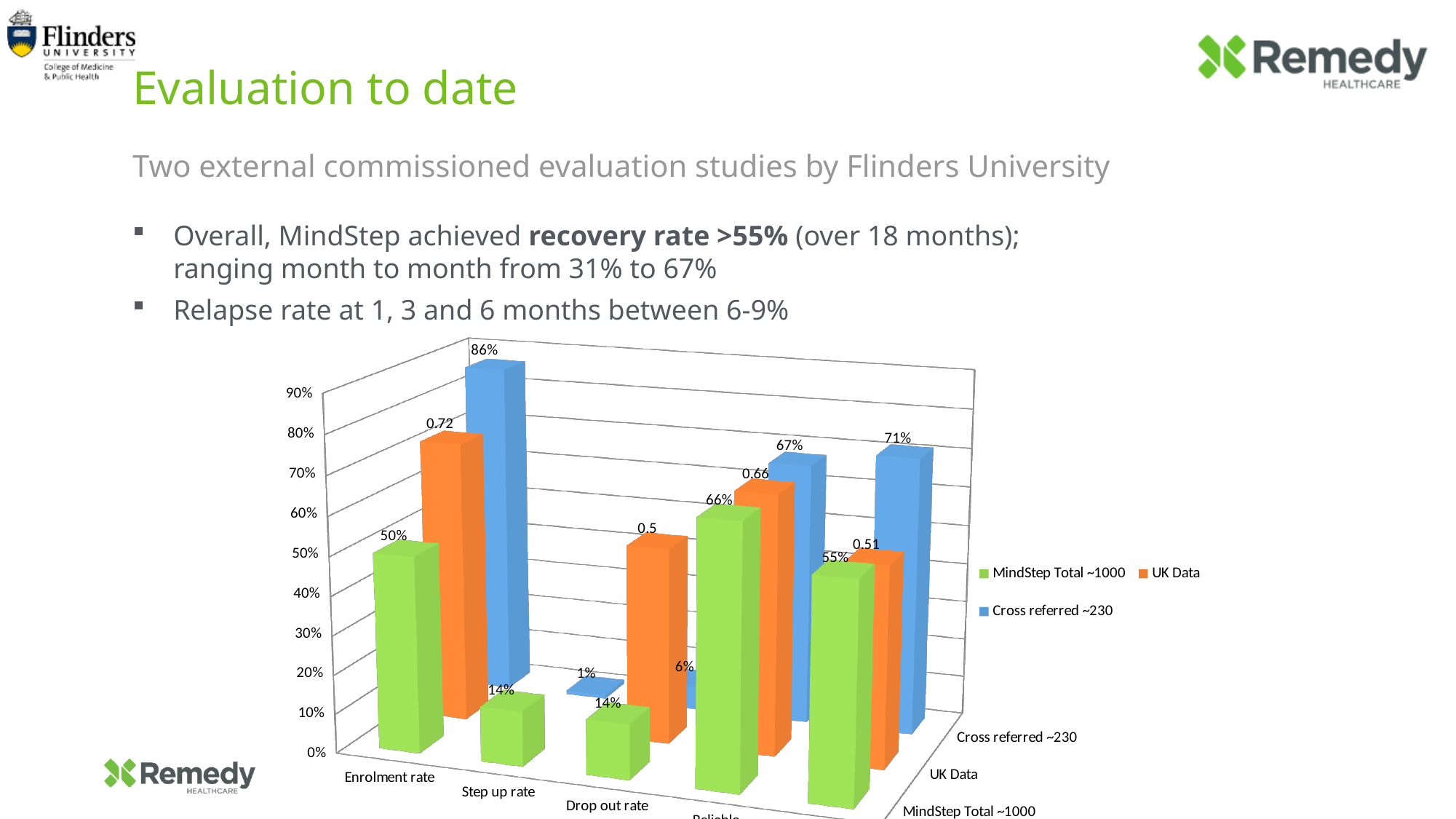
What value is shown for UK Data at Drop out rate? 0.5 What is the Step up rate for MindStep Total ~1000? 14% What value is shown for UK Data at Enrolment rate? 0.72 What kind of chart is shown on the slide? bar chart How many series does the chart legend list? 3 Which colour represents the UK Data series in the chart? orange What is the Enrolment rate for Cross referred ~230? 86% What is the Step up rate for Cross referred ~230? 1% Which series has the highest Enrolment rate? Cross referred ~230 What is the difference between the Enrolment rate for Cross referred ~230 and for MindStep Total ~1000? 36% What is the Enrolment rate for MindStep Total ~1000? 50% What is the Drop out rate for MindStep Total ~1000? 14%